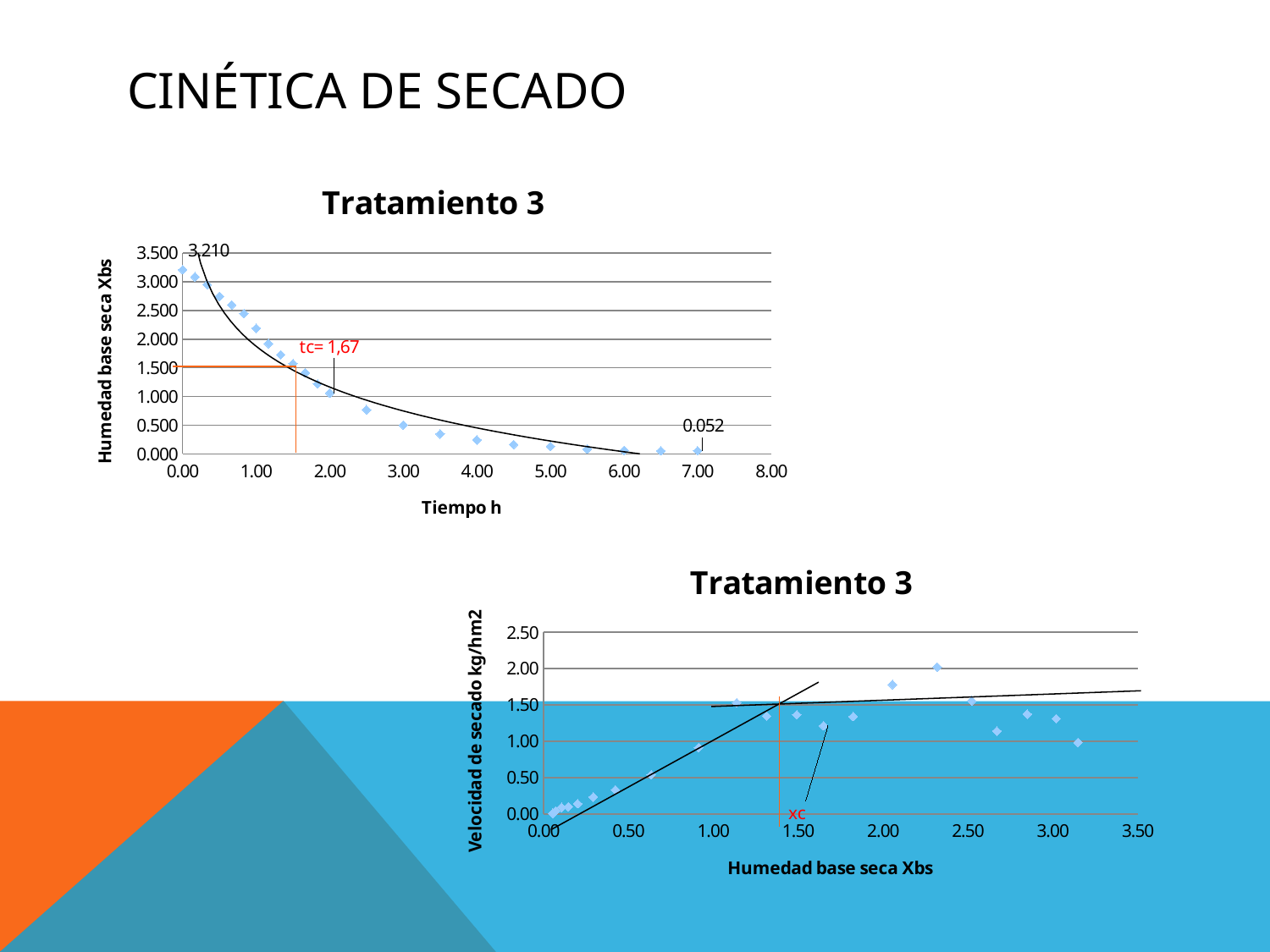
In the top chart, what critical time value is annotated in red? tc= 1,67 In the top chart, is the value at 1.00 h greater or less than 2.000? greater In the top chart, do the values rise or fall as time increases along the x axis? fall In the top chart, what is the title of the x axis? Tiempo h In the top chart (Humedad base seca Xbs vs Tiempo h), what kind of chart is it? scatter chart In the top chart, what is the data label shown for the first point at time 0.00 h? 3.210 In the top chart, is the value at 2.50 h greater or less than 1.000? less In the bottom chart, which is larger: the drying rate at Xbs 0.50 or at Xbs 1.00? Xbs 1.00 In the bottom chart, is the value at Xbs 2.30 greater or less than 1.50? greater In the top chart, what is the difference between the labelled values 3.210 and 0.052? 3.158 In the top chart, what is the data label shown for the point at 7.00 h? 0.052